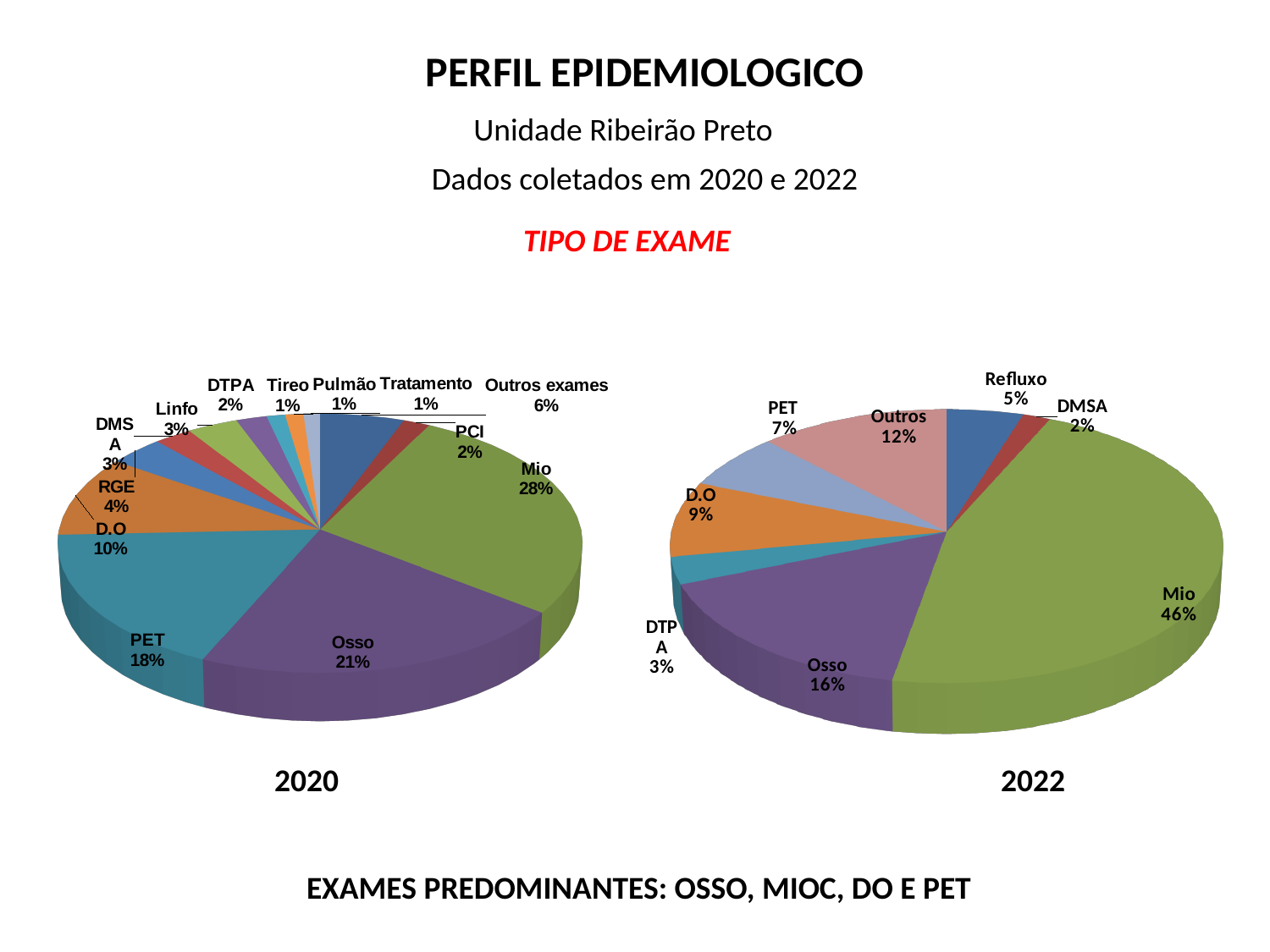
In the 2022 pie chart, what share does D.O have? 9% In the 2022 pie chart, which category has the largest share? Mio In the 2020 pie chart, what share does Mio have? 28% How many slices does the 2022 pie chart have? 8 In the 2020 pie chart, which category has the largest share? Mio In the 2020 pie chart, what is the difference between the Mio share and the Osso share? 7% What type of chart is used to show the 2020 data? Pie chart In the 2020 pie chart, what share does PET have? 18% In the 2022 pie chart, what share does Osso have? 16% In the 2022 pie chart, which category has the smallest share? DMSA In the 2020 pie chart, which is larger, the share for PET or the share for D.O? PET In the 2022 pie chart, what is the difference between the Outros share and the PET share? 5%